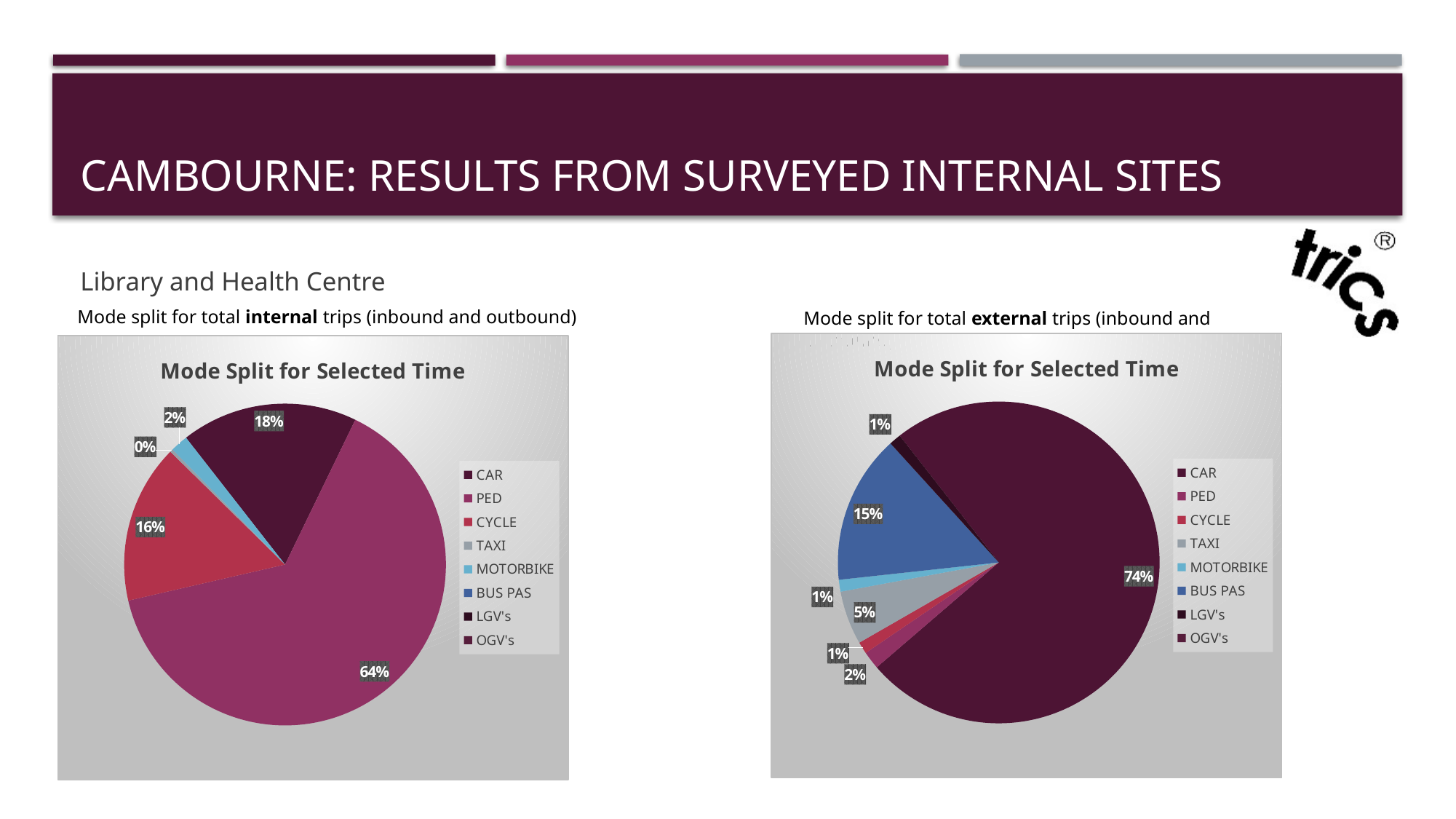
How many entries does the legend of the right chart list? 8 On the right chart (external trips), which is larger, the BUS PAS share or the TAXI share? BUS PAS On the right chart (external trips), which mode has the largest share? CAR On the left chart (internal trips), what share of trips is CAR? 18% On the right chart (external trips), what share of trips is CAR? 74% On the left chart (internal trips), what is the difference between the PED share and the CAR share? 46% On the left chart (internal trips), what share of trips is PED? 64% On the right chart (external trips), what share of trips is TAXI? 5% What type of chart is used on the left side of the slide? Pie chart On the right chart (external trips), what share of trips is BUS PAS? 15% On the left chart (internal trips), what share of trips is CYCLE? 16% On the left chart (internal trips), which mode has the largest share? PED